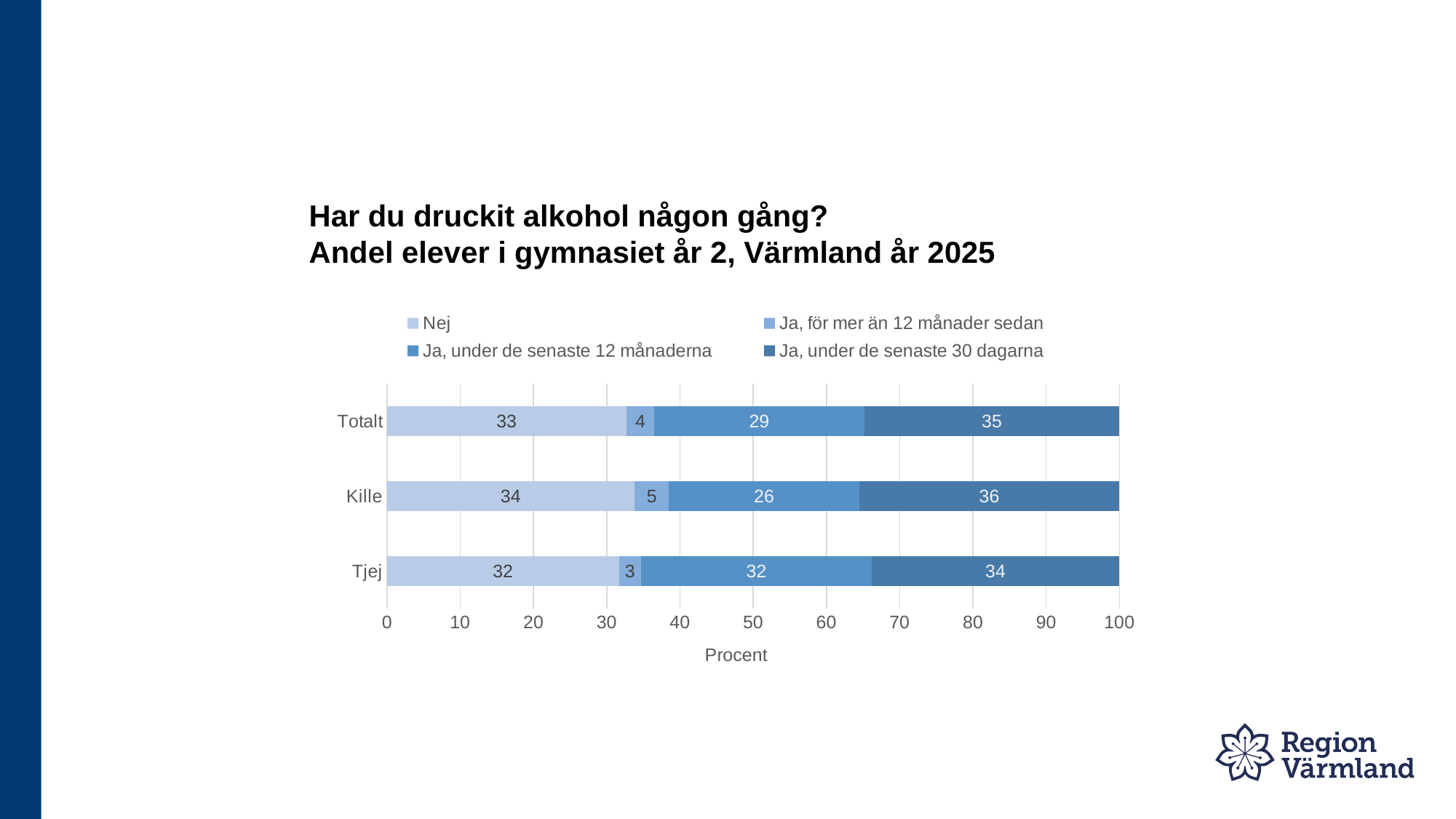
How many series does the legend list? 4 Which category has the lowest value for "Ja, för mer än 12 månader sedan"? Tjej What is the value for "Ja, under de senaste 30 dagarna" for Kille? 36 Which is larger: the "Nej" value for Kille or for Tjej? Kille Which category has the highest value for "Ja, under de senaste 12 månaderna"? Tjej What is the label of the x axis? Procent What kind of chart is shown? Stacked bar chart How many categories are shown on the y axis? 3 What is the difference between the "Ja, under de senaste 12 månaderna" values for Tjej and Kille? 6 What is the value for "Ja, under de senaste 12 månaderna" for Tjej? 32 What is the value for "Nej" for Totalt? 33 What is the value for "Ja, för mer än 12 månader sedan" for Tjej? 3